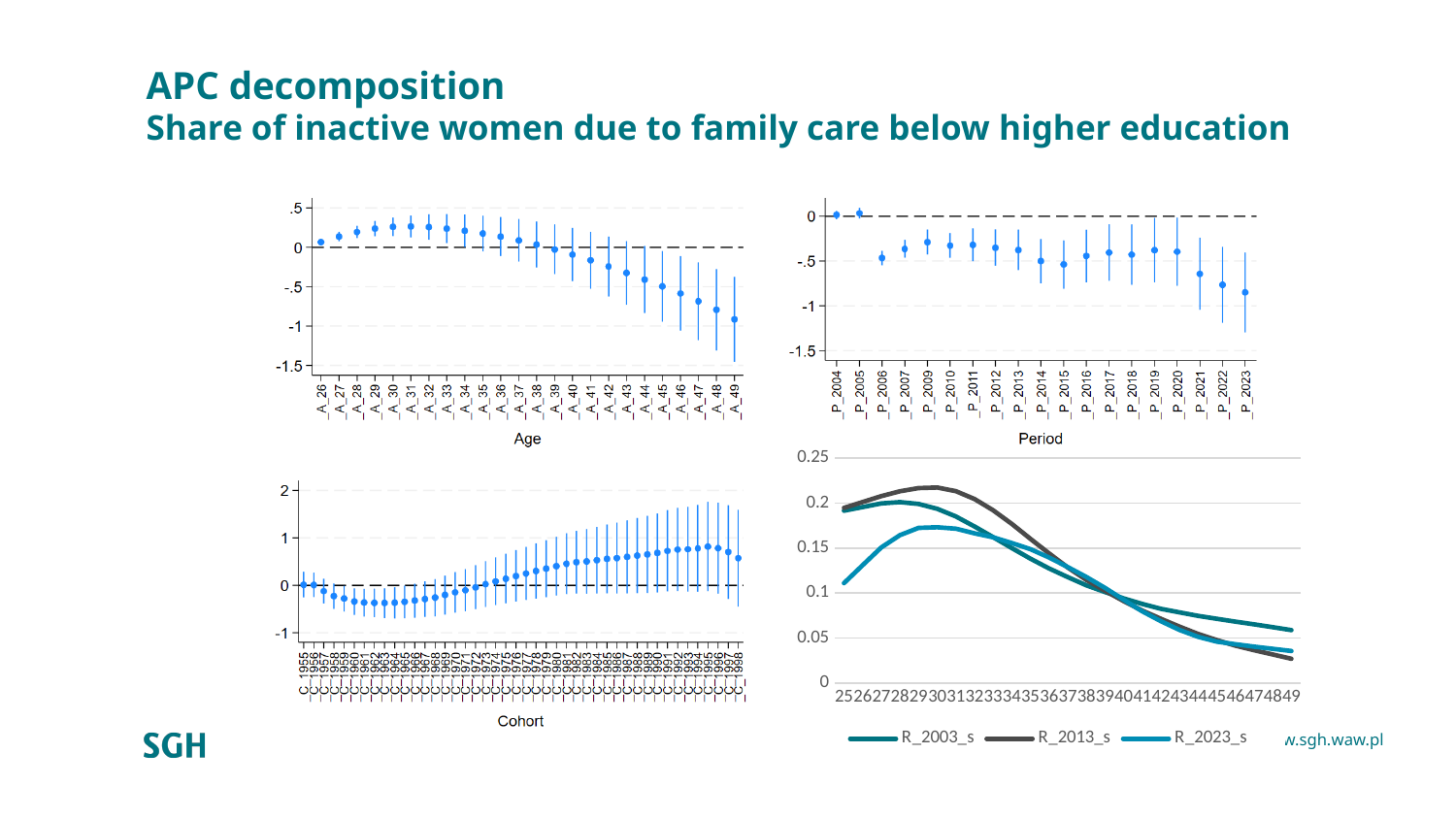
In the Period chart (top-right), how many period points are plotted? 19 What kind of chart is the bottom-right chart with the legend R_2003_s, R_2013_s, R_2023_s? line chart In the bottom-right line chart, which series has the highest value at 29? R_2013_s In the Cohort chart (bottom-left), do the values rise or fall from C_1970 to C_1995? rise In the bottom-right line chart, do the values of R_2003_s rise or fall from 30 to 49? fall In the Age chart (top-left), is the value for A_49 greater or less than -0.5? less In the bottom-right line chart, which series has the lowest value at 25? R_2023_s In the Period chart (top-right), is the value for P_2021 greater or less than -0.5? less In the bottom-right line chart, is the value of R_2013_s at 49 greater or less than 0.05? less How many series does the legend of the bottom-right line chart list? 3